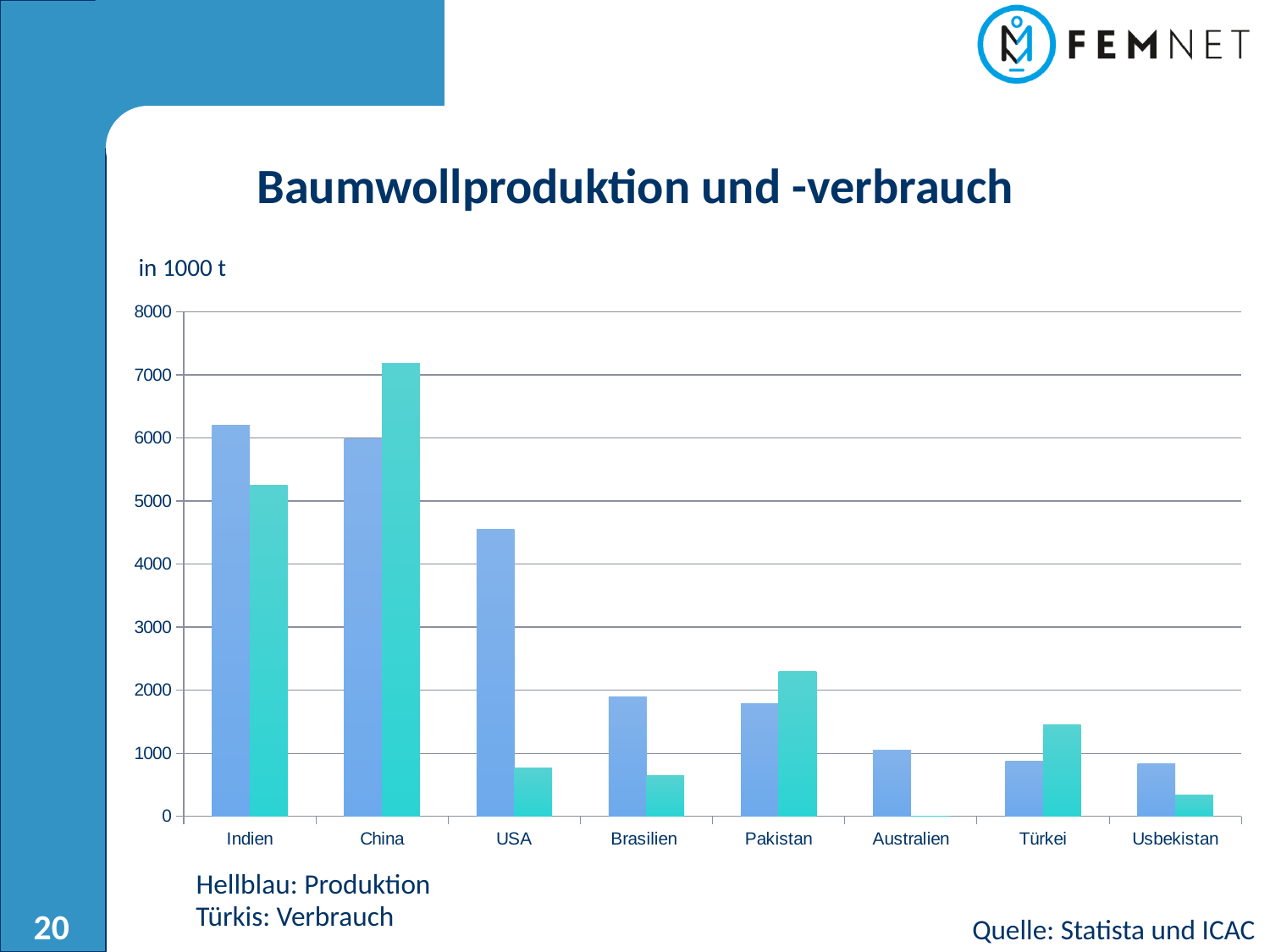
Which country has the highest cotton consumption (turquoise bar)? China For China, which is larger: production or consumption? consumption (Verbrauch) Is the production value for the USA greater or less than 4000? greater What kind of chart is shown on the slide? bar chart Which country has the highest cotton production (light blue bar)? Indien For the USA, which is larger: production or consumption? production (Produktion) Is the consumption value for Pakistan greater or less than 2000? greater Which country has the lowest cotton consumption (turquoise bar)? Australien Is the consumption value for Brasilien greater or less than 1000? less What unit is given for the values on the chart? in 1000 t How many data series does the chart show according to the colour key below it? 2 How many countries are shown on the x axis of the chart? 8